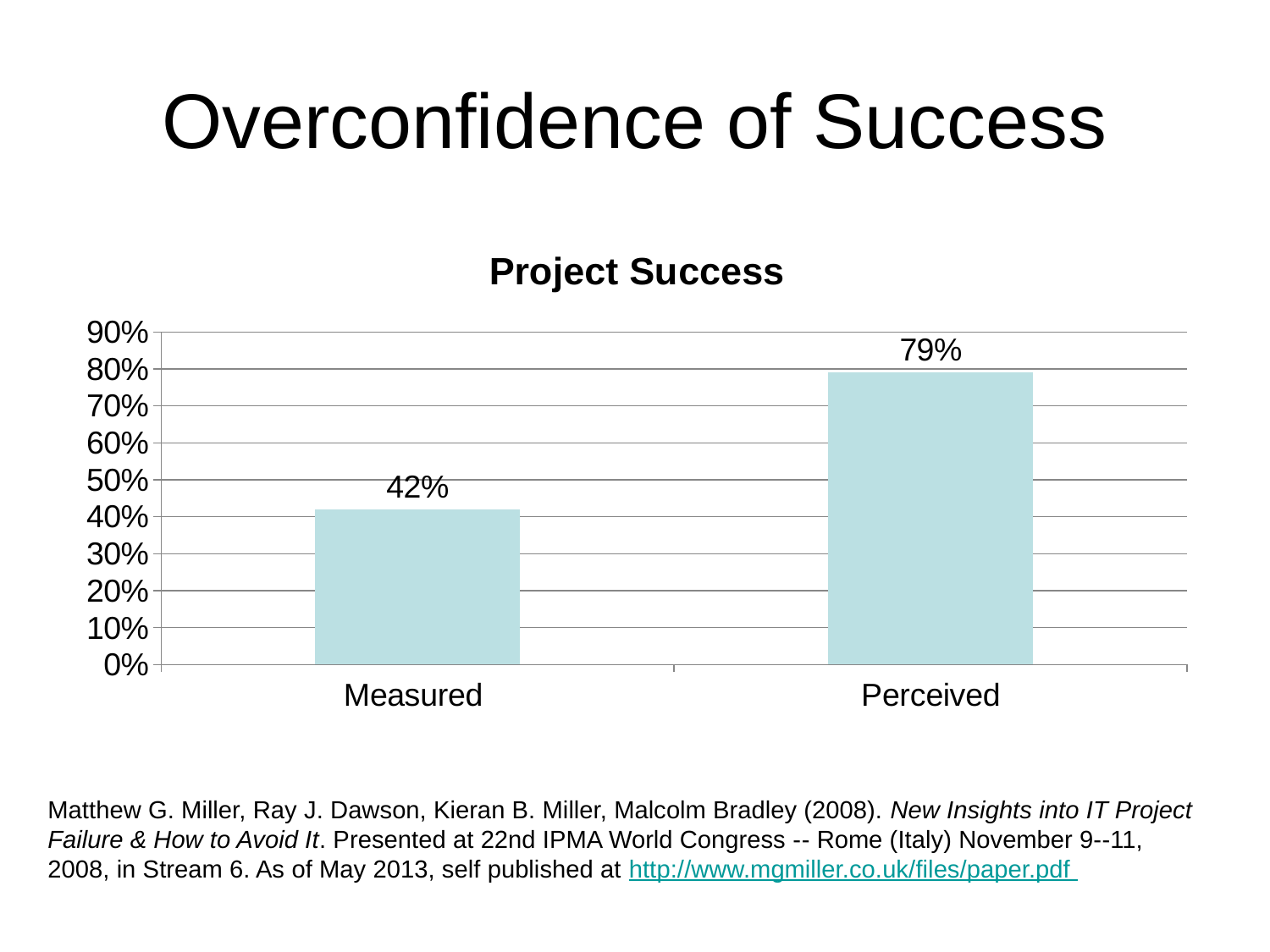
What is the title of the chart? Project Success Which is larger, the value for Measured or the value for Perceived? Perceived What is the value for Measured? 42% What kind of chart is shown on the slide? bar chart Is the value for Measured greater or less than 50%? less What is the highest value shown on the vertical axis? 90% What is the value for Perceived? 79% What is the difference between the Perceived and Measured values? 37% Is the value for Perceived greater or less than 70%? greater How many categories are shown on the chart? 2 Which category has the highest value? Perceived Which category has the lowest value? Measured